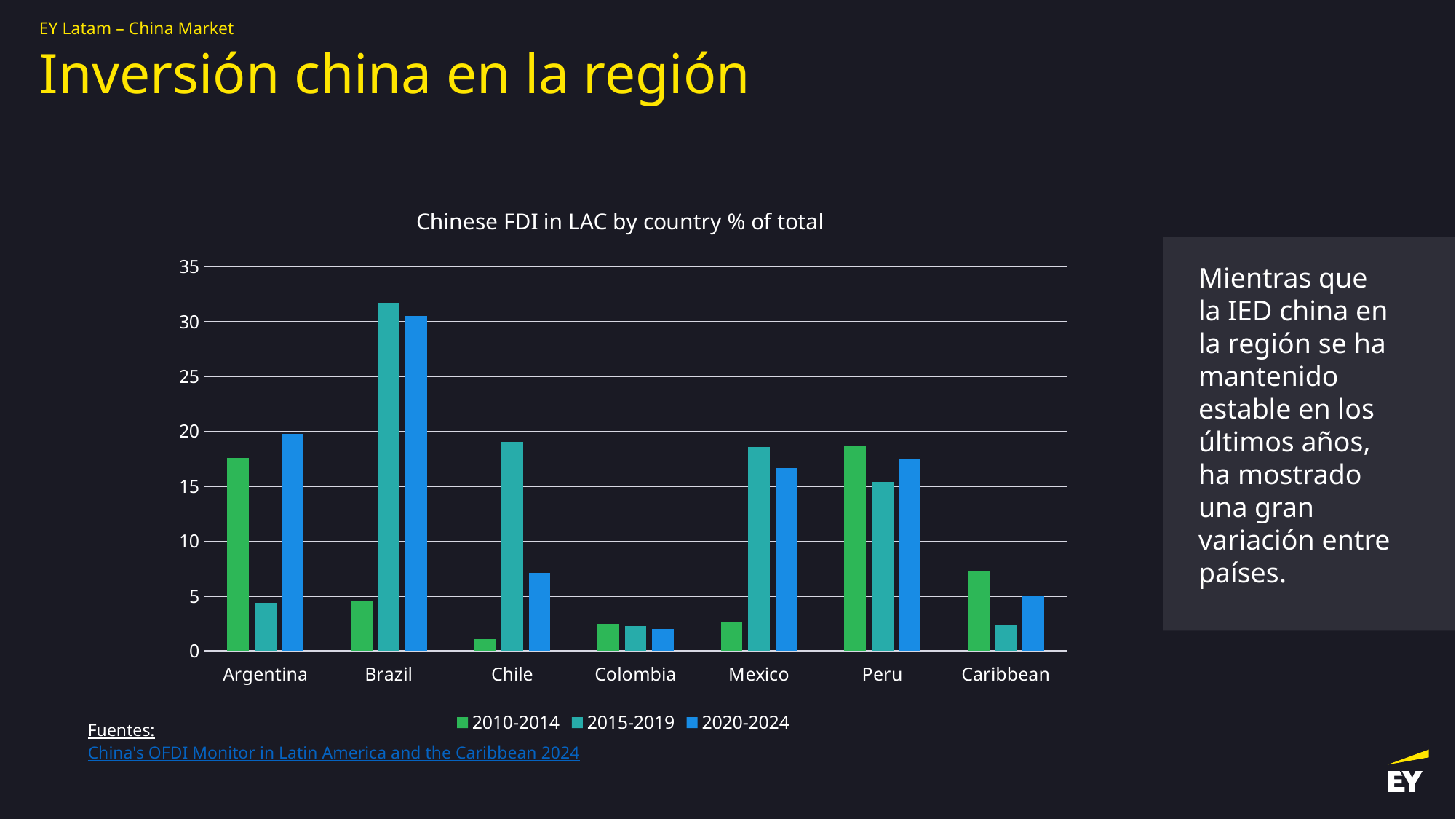
How many countries/regions are shown on the x axis of the chart? 7 Is the value for Argentina in 2020-2024 greater or less than 15? greater Is the value for Colombia in 2010-2014 greater or less than 5? less How many series does the chart's legend list? 3 For Argentina, which series has the larger value: 2010-2014 or 2015-2019? 2010-2014 Which country has the lowest value for the 2010-2014 series? Chile What is the title of the chart? Chinese FDI in LAC by country % of total What kind of chart is shown on the slide? Bar chart Is the value for Brazil in 2015-2019 greater or less than 25? greater Which country has the highest value for the 2020-2024 series? Brazil Which country has the highest value for the 2015-2019 series? Brazil For Chile, which series has the larger value: 2015-2019 or 2020-2024? 2015-2019